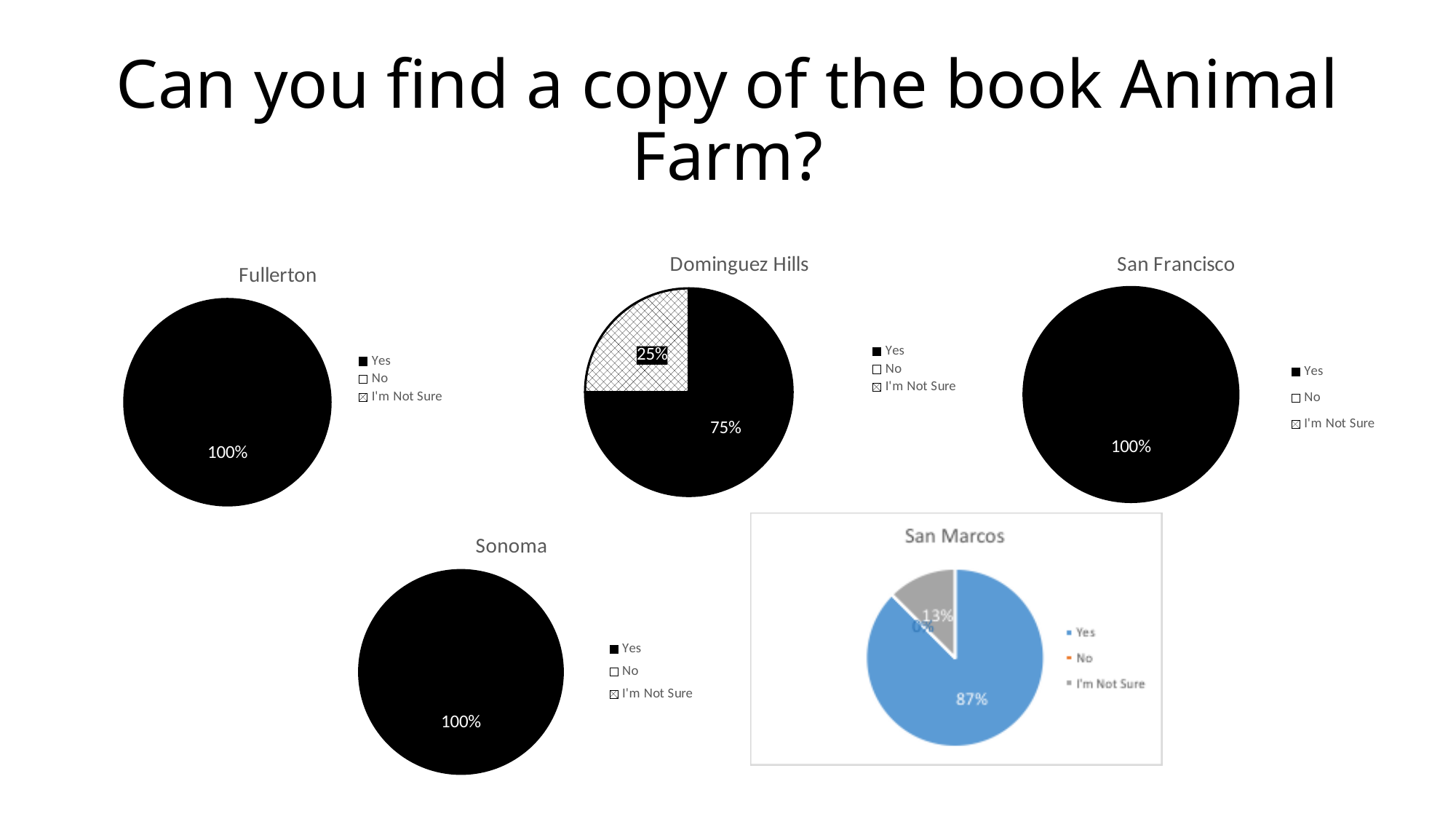
In the Dominguez Hills chart, what is the difference between the Yes and I'm Not Sure percentages? 50% In the Fullerton chart, what share of the pie is labelled for Yes? 100% In the San Marcos chart, what percentage is shown for the Yes slice? 87% In the San Francisco chart, what percentage is shown for Yes? 100% In the Dominguez Hills chart, what percentage is shown for the I'm Not Sure slice? 25% In the San Marcos chart, which slice is the largest? Yes How many entries does the legend of the Fullerton chart list? 3 In the Dominguez Hills chart, which slice is larger, Yes or I'm Not Sure? Yes What kind of chart is the Dominguez Hills chart? Pie chart In the Dominguez Hills chart, what percentage is shown for the Yes slice? 75% In the San Marcos chart, what percentage is shown for the I'm Not Sure slice? 13% In the Sonoma chart, what percentage is shown for Yes? 100%